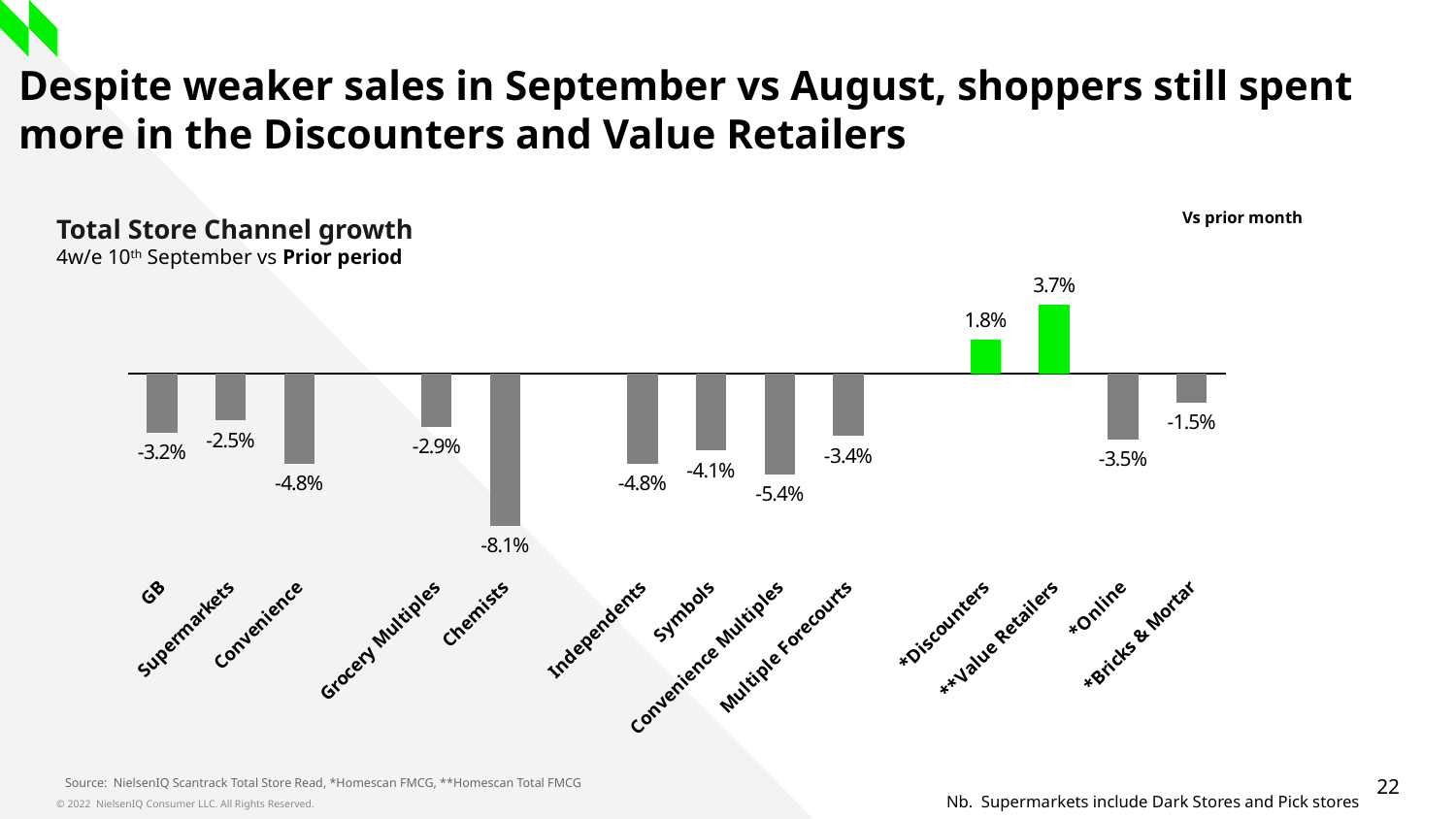
What is the value for GB? -3.2% What kind of chart is this? Bar chart Which channel has the highest growth? Value Retailers How many channels are shown on the chart? 13 What is the title of the chart? Total Store Channel growth What is the value for Value Retailers? 3.7% What is the value for Chemists? -8.1% Which is larger, the value for Supermarkets or the value for Convenience? Supermarkets What is the value for Discounters? 1.8% Which channel has the lowest growth? Chemists What is the difference between the values for Value Retailers and Discounters? 1.9 percentage points What is the value for Online? -3.5%